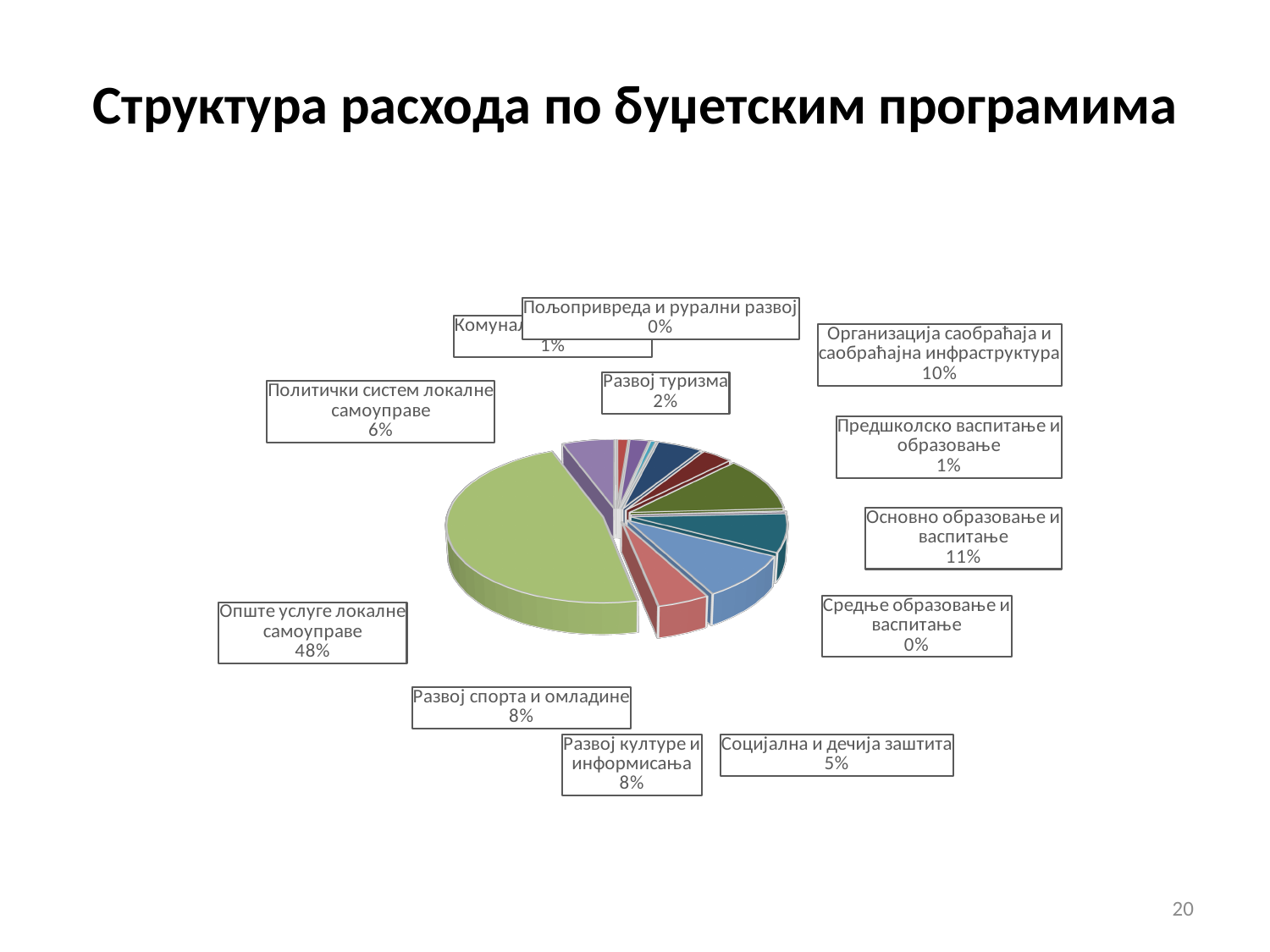
Which is larger, the share for Развој спорта и омладине or the share for Социјална и дечија заштита? Развој спорта и омладине What percentage is shown for Политички систем локалне самоуправе? 6% What share of the pie does Опште услуге локалне самоуправе have? 48% What kind of chart is shown on the slide? pie chart What is the difference in percentage points between Опште услуге локалне самоуправе and Основно образовање и васпитање? 37 Which category has the largest share of the pie? Опште услуге локалне самоуправе What percentage is shown for Развој туризма? 2% How many categories are labelled on the pie chart? 12 What percentage is shown for Основно образовање и васпитање? 11% What is the title of the chart on the slide? Структура расхода по буџетским програмима What percentage is shown for Социјална и дечија заштита? 5% What percentage is shown for Организација саобраћаја и саобраћајна инфраструктура? 10%